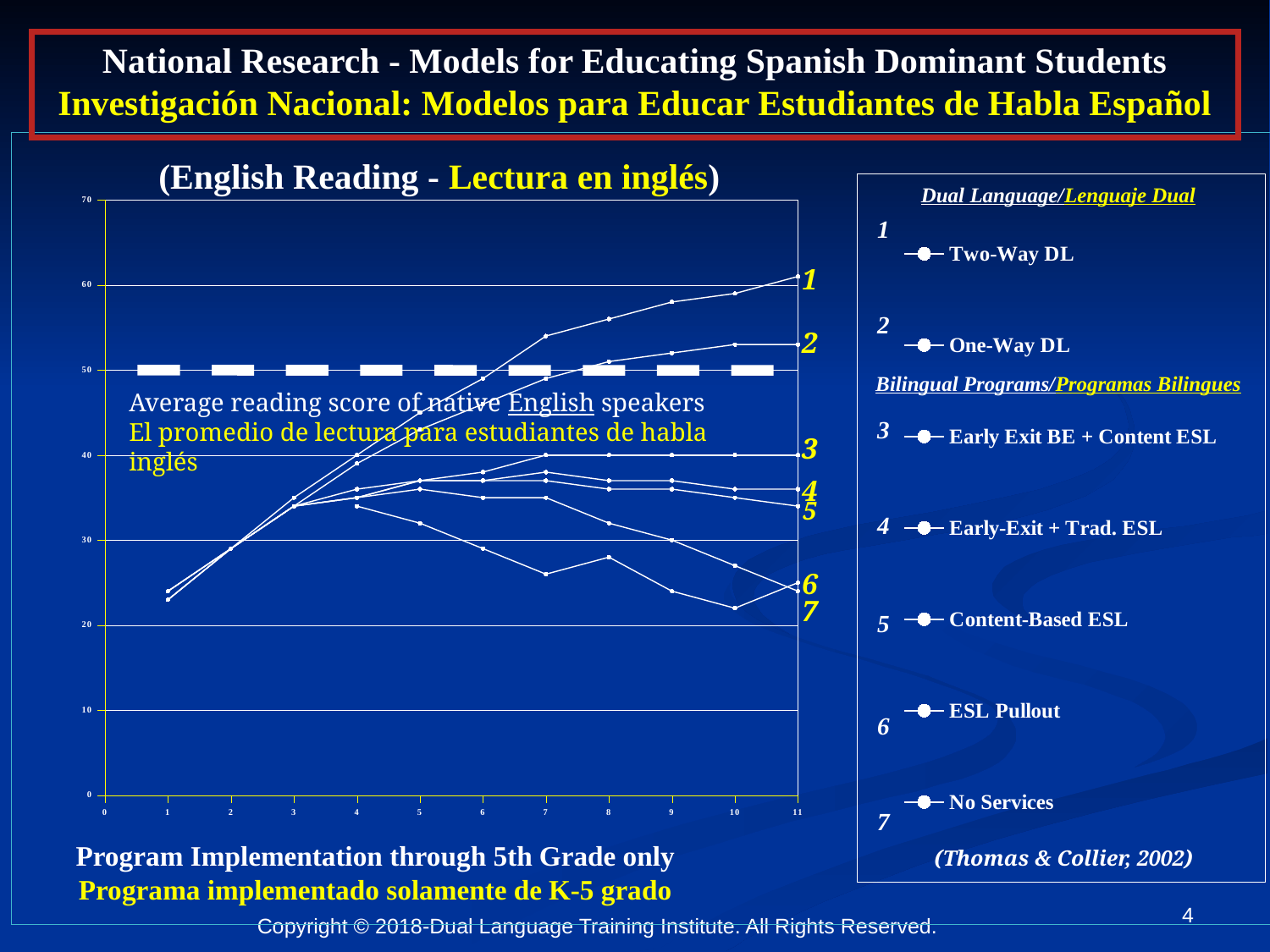
Is the value for Early-Exit + Trad. ESL at grade 11 greater or less than 40? less Is the value for Two-Way DL at grade 11 greater or less than 50? greater Is the value for No Services at grade 11 greater or less than 30? less How many series does the legend list? 7 Does the Two-Way DL line rise or fall from grade 1 to grade 11? rise At grade 11, which is larger: Two-Way DL or ESL Pullout? Two-Way DL What kind of chart is shown on the slide? line chart What source is cited for the chart? Thomas & Collier, 2002 Which series has the highest value at grade 11? Two-Way DL At grade 11, which is larger: One-Way DL or Early Exit BE + Content ESL? One-Way DL What does the dashed horizontal line at 50 represent? Average reading score of native English speakers